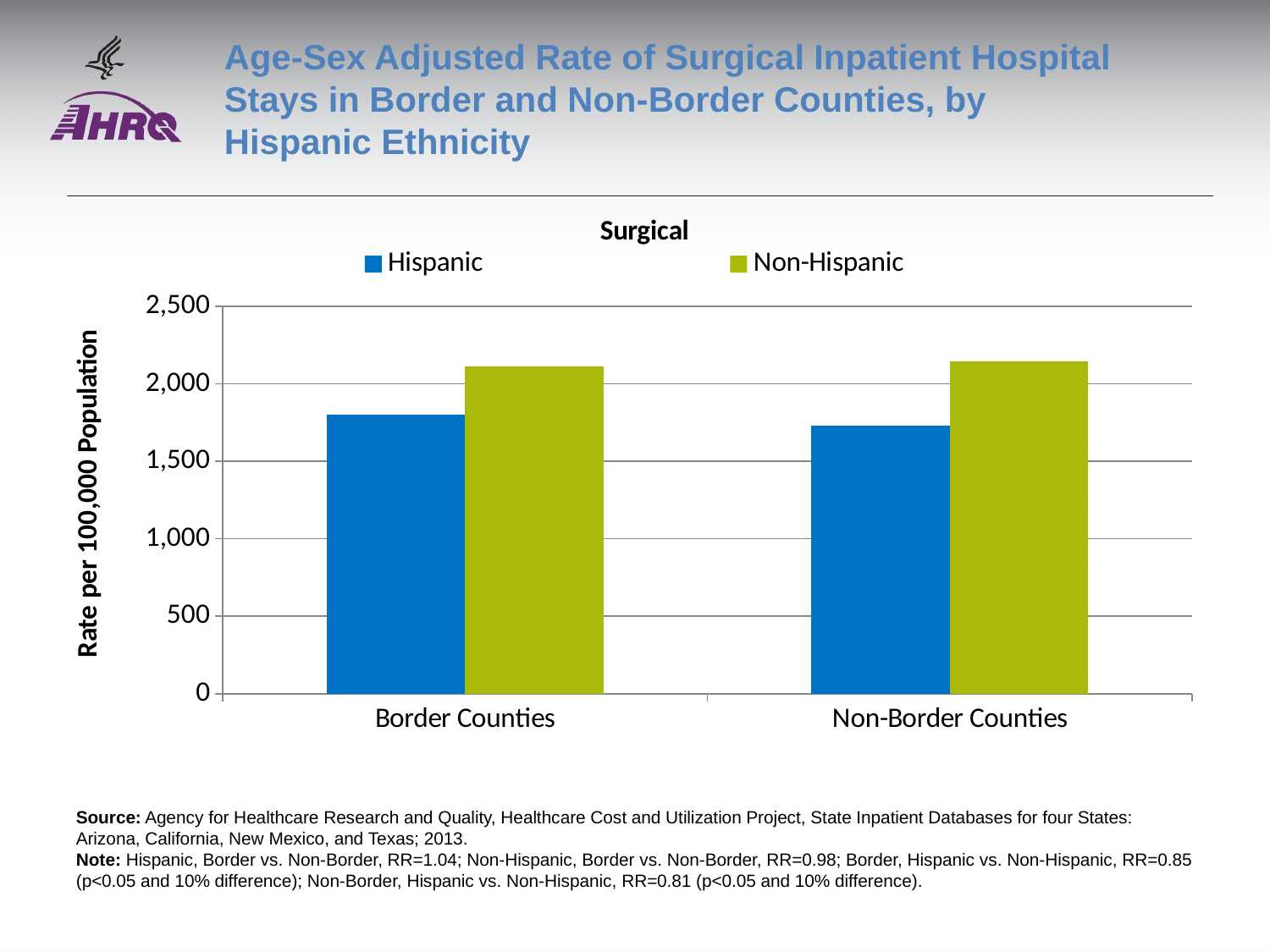
In Non-Border Counties, which series has the lower rate, Hispanic or Non-Hispanic? Hispanic How many categories are shown on the x axis? 2 Is the Hispanic value for Border Counties greater or less than 2,000? less How many series does the legend list? 2 What is the label of the y axis? Rate per 100,000 Population What type of chart is shown on the slide? bar chart In Border Counties, which series has the higher rate, Hispanic or Non-Hispanic? Non-Hispanic Is the Hispanic value for Non-Border Counties greater or less than 2,000? less Is the Non-Hispanic value for Border Counties greater or less than 2,000? greater What is the title of the chart? Surgical